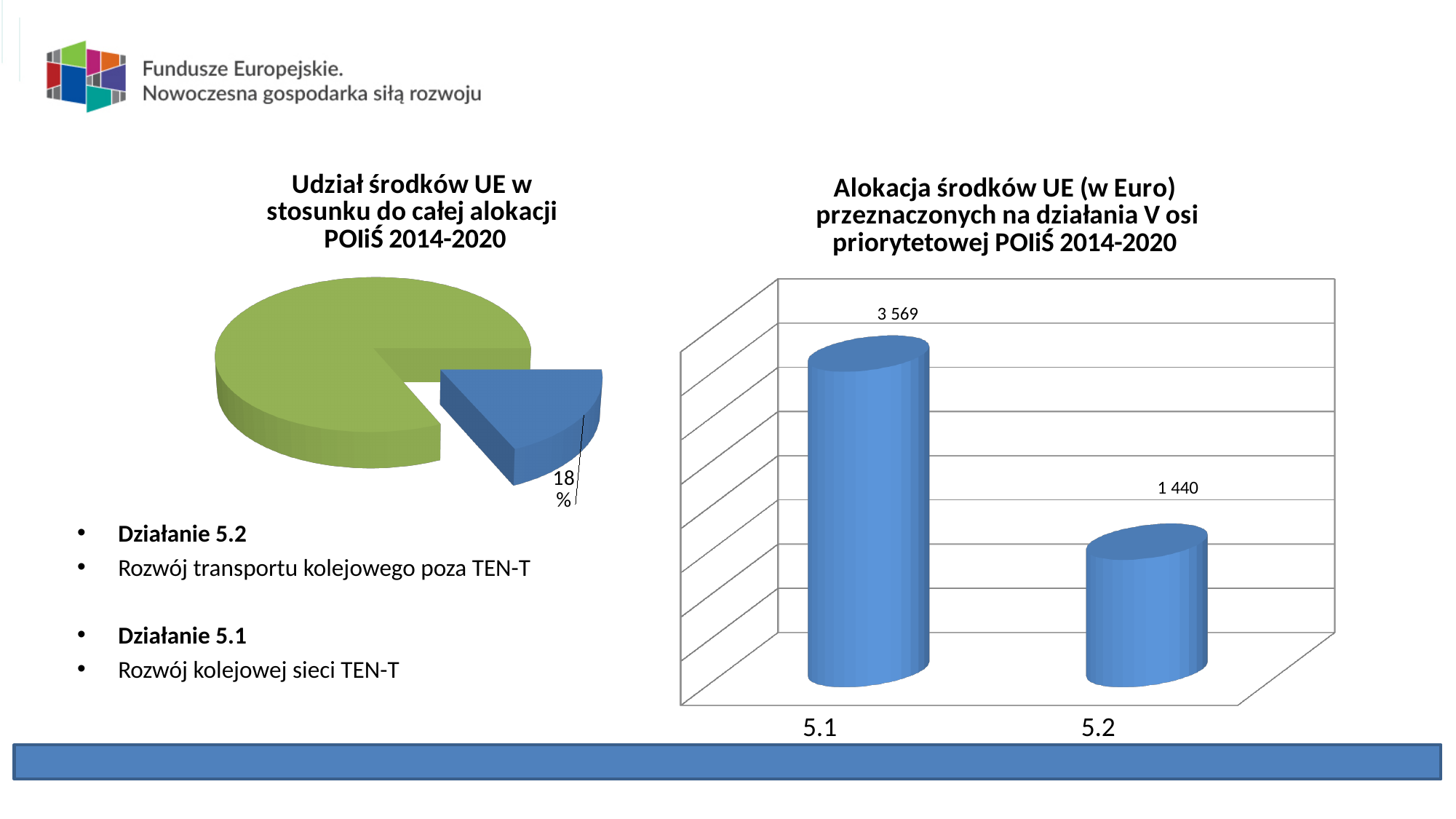
What is the title of the chart on the right of the slide? Alokacja środków UE (w Euro) przeznaczonych na działania V osi priorytetowej POIiŚ 2014-2020 What kind of chart is the chart on the left of the slide? pie chart In the pie chart on the left, what share is shown for the exploded blue slice? 18% How many categories are shown in the bar chart on the right? 2 In the bar chart on the right, what is the value for 5.2? 1 440 In the bar chart on the right, do the values rise or fall from 5.1 to 5.2? fall In the bar chart on the right, what is the difference between the values for 5.1 and 5.2? 2 129 In the bar chart on the right, which category has the highest value? 5.1 In the bar chart on the right, which category has the lowest value? 5.2 What kind of chart is the chart on the right of the slide? bar chart In the bar chart on the right, which is larger: the value for 5.1 or the value for 5.2? 5.1 In the bar chart on the right, what is the value for 5.1? 3 569